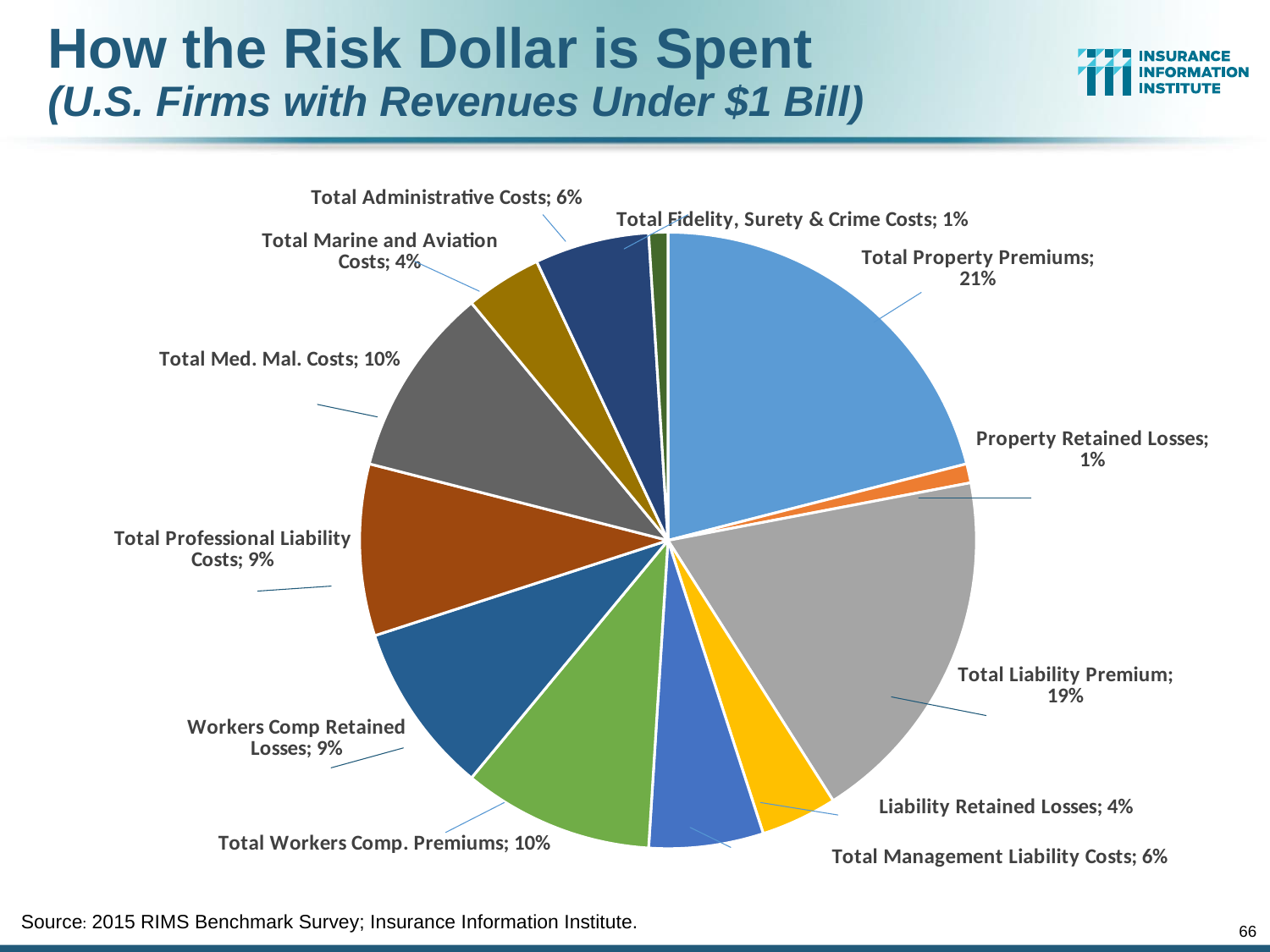
Which is larger, Total Workers Comp. Premiums or Workers Comp Retained Losses? Total Workers Comp. Premiums What percentage is shown for Total Liability Premium? 19% What is the value for Total Med. Mal. Costs? 10% Which category has the largest slice of the pie? Total Property Premiums What is the difference between Total Property Premiums and Total Liability Premium? 2% How many slices does the pie chart have? 12 What is the title of the slide containing the chart? How the Risk Dollar is Spent (U.S. Firms with Revenues Under $1 Bill) What is the value shown for Total Fidelity, Surety & Crime Costs? 1% What share of the risk dollar goes to Total Property Premiums? 21% What is the combined share of Total Administrative Costs and Total Management Liability Costs? 12% What kind of chart is shown on the slide? pie chart What percentage is labeled for Total Marine and Aviation Costs? 4%